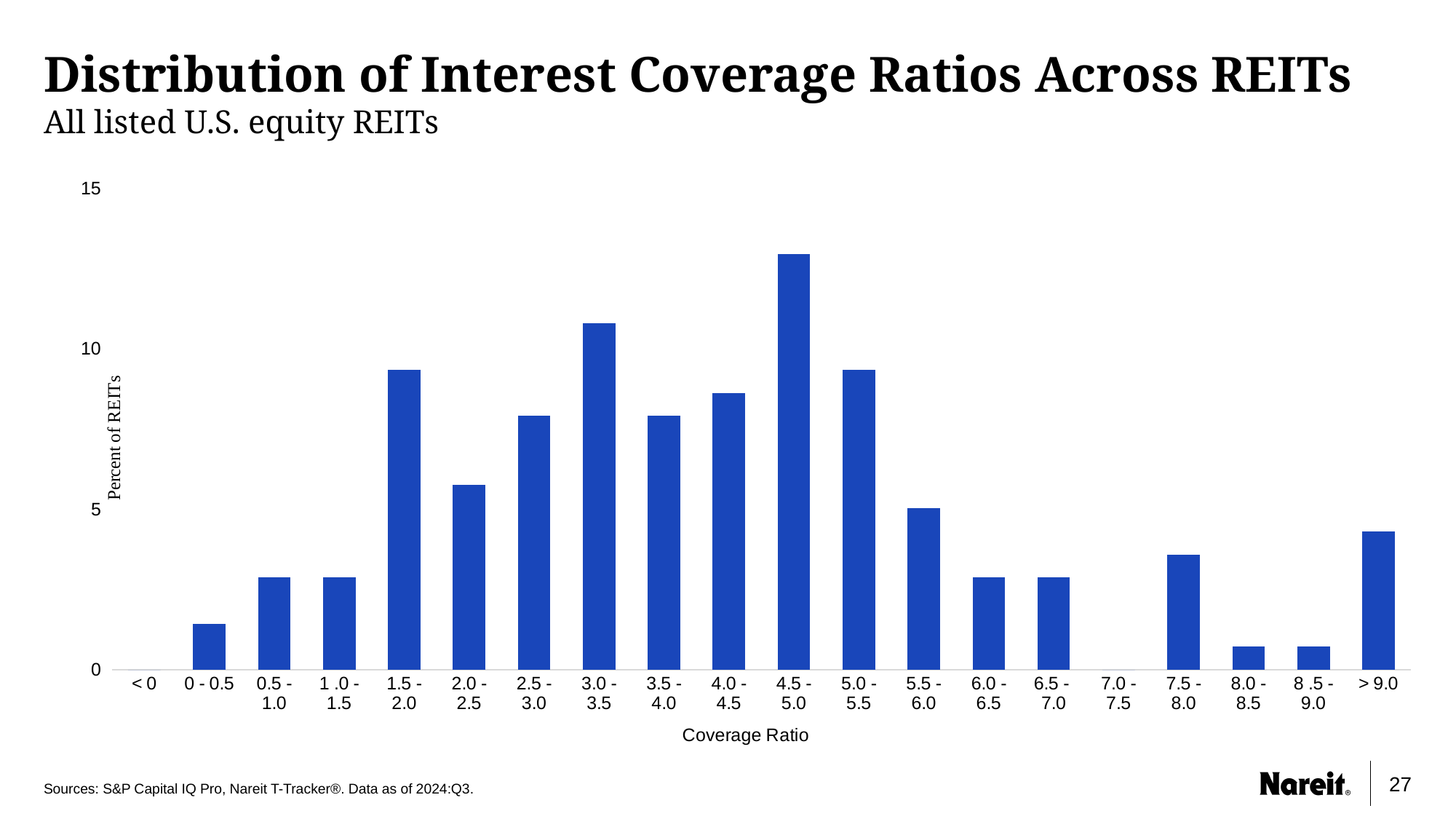
Which is larger, the value for 7.5 - 8.0 or the value for 6.0 - 6.5? 7.5 - 8.0 What is the title of the chart's vertical axis? Percent of REITs Is the value for the > 9.0 category greater or less than 5? less Is the value for the 4.5 - 5.0 category greater or less than 10? greater What kind of chart is shown on the slide? bar chart What is the title of the chart's horizontal axis? Coverage Ratio Which coverage ratio category has the highest percent of REITs? 4.5 - 5.0 How many coverage ratio categories are shown on the x axis? 20 Is the value for the 1.5 - 2.0 category greater or less than 10? less Which is larger, the value for 3.0 - 3.5 or the value for 4.5 - 5.0? 4.5 - 5.0 Which is larger, the value for 1.5 - 2.0 or the value for 2.0 - 2.5? 1.5 - 2.0